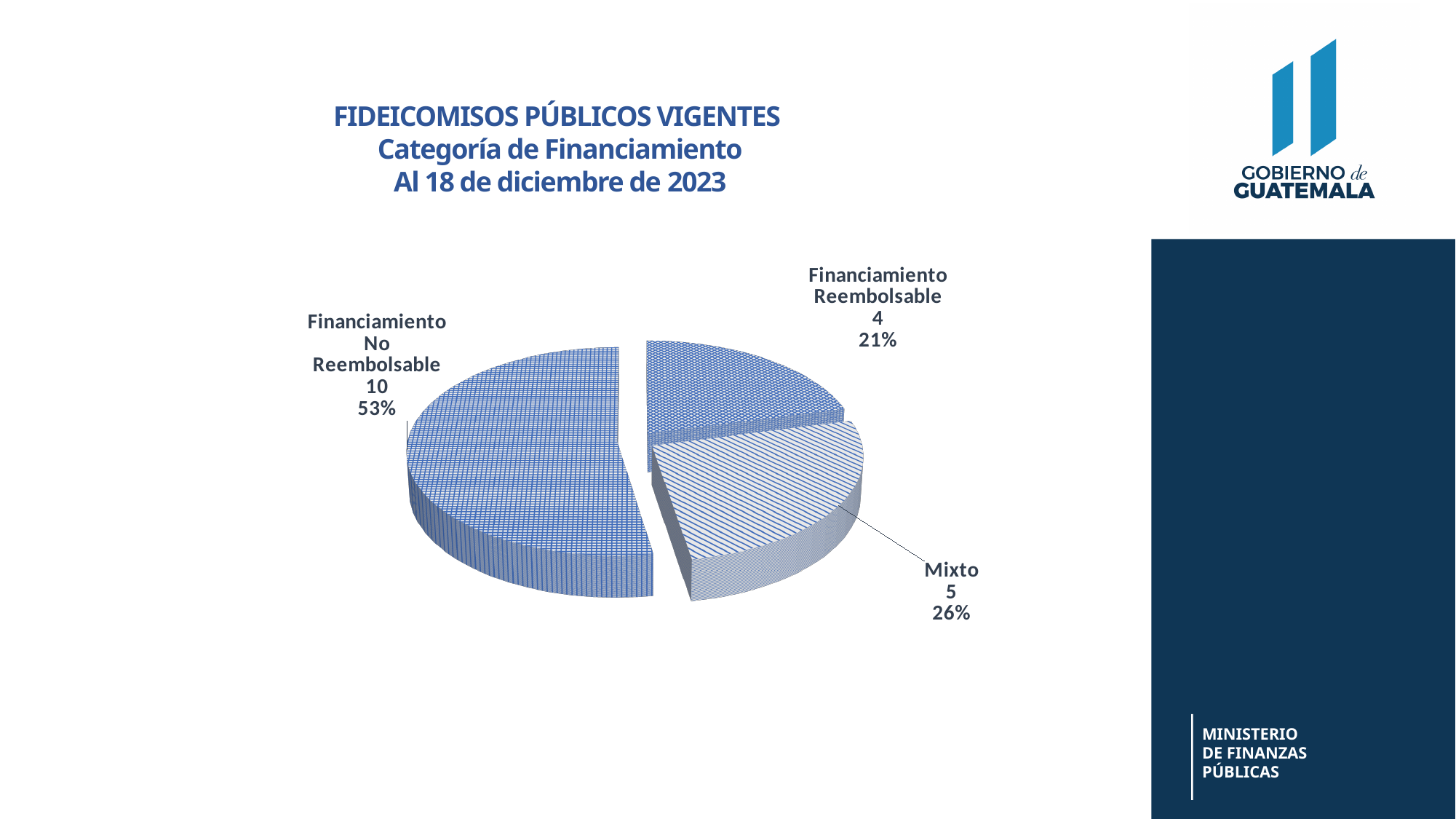
What share of the pie does Financiamiento No Reembolsable represent? 53% What is the value for Financiamiento Reembolsable? 4 What is the value for Mixto? 5 What type of chart is shown on the slide? Pie chart What is the value for Financiamiento No Reembolsable? 10 What is the total of all the values shown in the pie chart? 19 What is the difference between the values for Financiamiento No Reembolsable and Mixto? 5 What share of the pie does Financiamiento Reembolsable represent? 21% What share of the pie does Mixto represent? 26% How many categories does the pie chart show? 3 Which category has the smallest value? Financiamiento Reembolsable Which category has the largest value? Financiamiento No Reembolsable